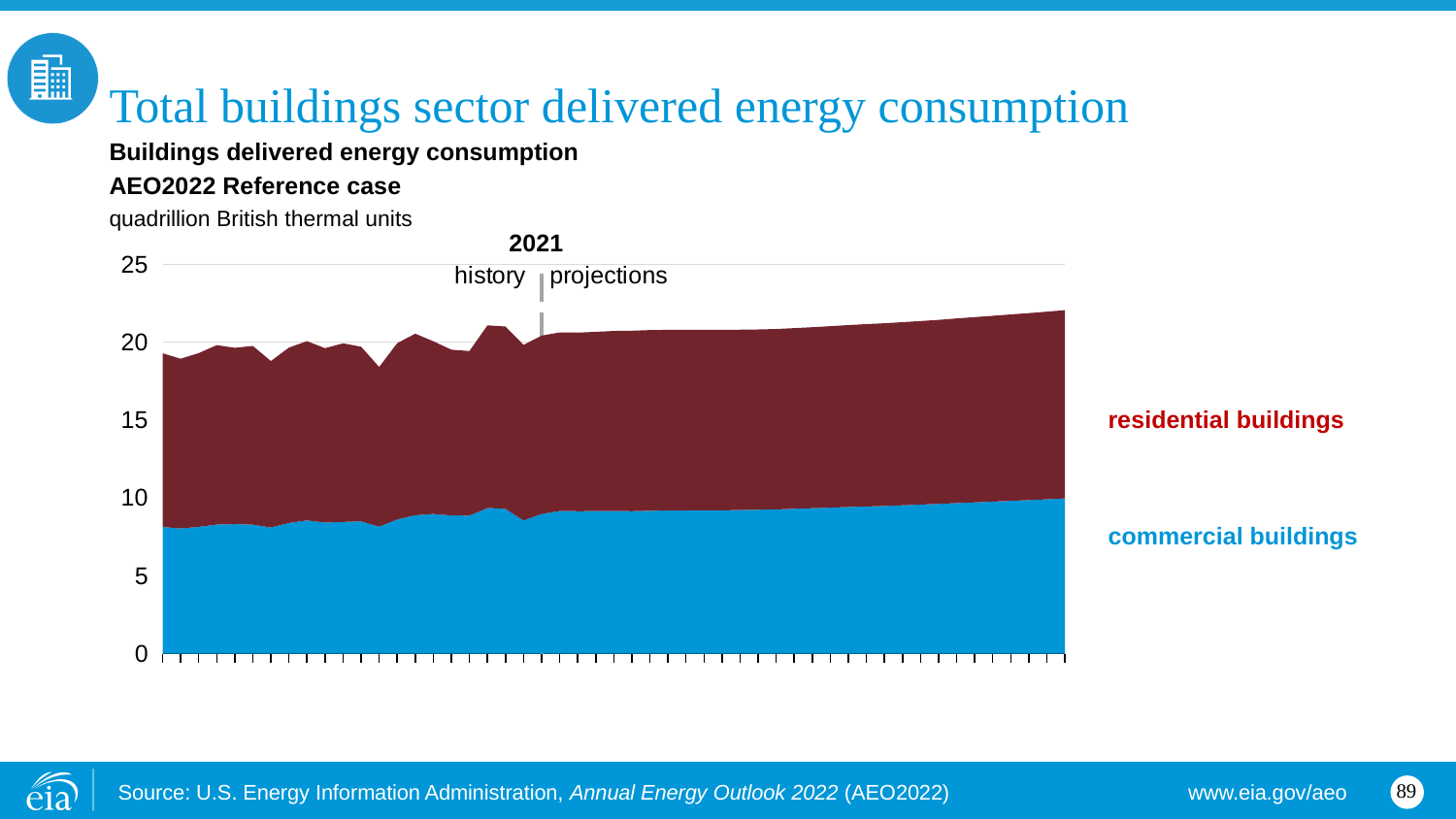
Is the total buildings delivered energy consumption at the start of the history period greater or less than 20? less What kind of chart is shown on the slide? stacked area chart Which year separates history from projections in the chart? 2021 What are the two series shown in the chart? residential buildings and commercial buildings Which series is plotted at the bottom of the stacked area chart? commercial buildings Is the total buildings delivered energy consumption at the end of the projection period greater or less than 20? greater What is the highest value shown on the y axis of the chart? 25 How many series are plotted in the chart? 2 Is the commercial buildings energy consumption at the start of the history period greater or less than 10? less Does total buildings delivered energy consumption rise or fall over the projection period? rise Which series accounts for more delivered energy consumption, residential buildings or commercial buildings? residential buildings What unit is the y axis of the chart measured in? quadrillion British thermal units